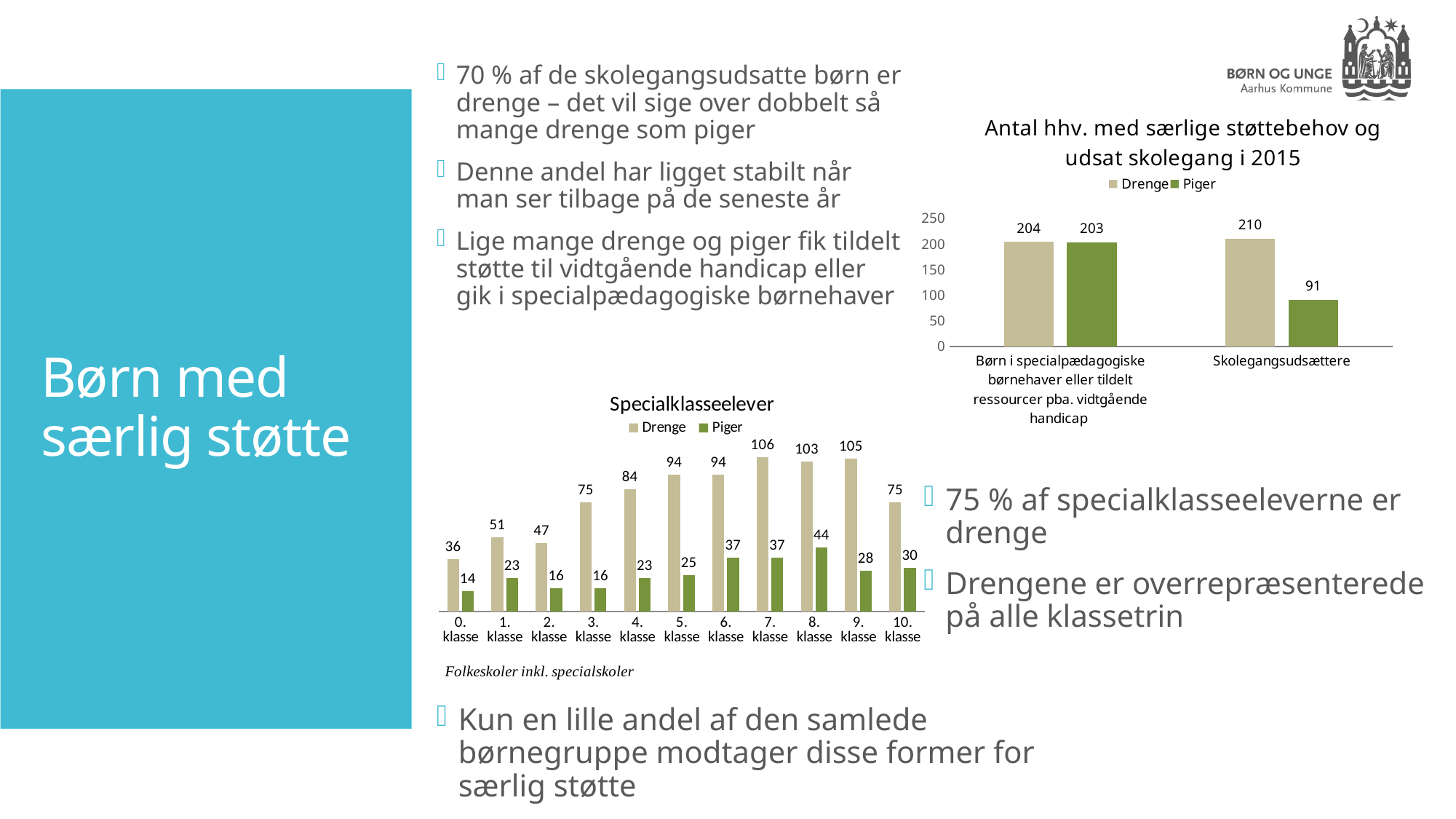
In the chart 'Antal hhv. med særlige støttebehov og udsat skolegang i 2015', what is the value for Drenge in the first category (Børn i specialpædagogiske børnehaver eller tildelt ressourcer pba. vidtgående handicap)? 204 In the chart 'Antal hhv. med særlige støttebehov og udsat skolegang i 2015', what is the value for Piger under Skolegangsudsættere? 91 In the 'Specialklasseelever' chart, what is the difference between Drenge and Piger in 9. klasse? 77 In the chart 'Antal hhv. med særlige støttebehov og udsat skolegang i 2015', what is the difference between Drenge and Piger under Skolegangsudsættere? 119 In the 'Specialklasseelever' chart, which klasse has the lowest value for Piger? 0. klasse In the 'Specialklasseelever' chart, what is the value for Drenge in 7. klasse? 106 In the 'Specialklasseelever' chart, how many klasse categories are shown on the x axis? 11 What kind of chart is the 'Specialklasseelever' chart? Bar chart In the chart 'Antal hhv. med særlige støttebehov og udsat skolegang i 2015', how many series does the legend list? 2 In the 'Specialklasseelever' chart, which klasse has the highest value for Drenge? 7. klasse In the 'Specialklasseelever' chart, which is larger: Piger in 6. klasse or Piger in 10. klasse? Piger in 6. klasse In the 'Specialklasseelever' chart, what is the value for Piger in 8. klasse? 44